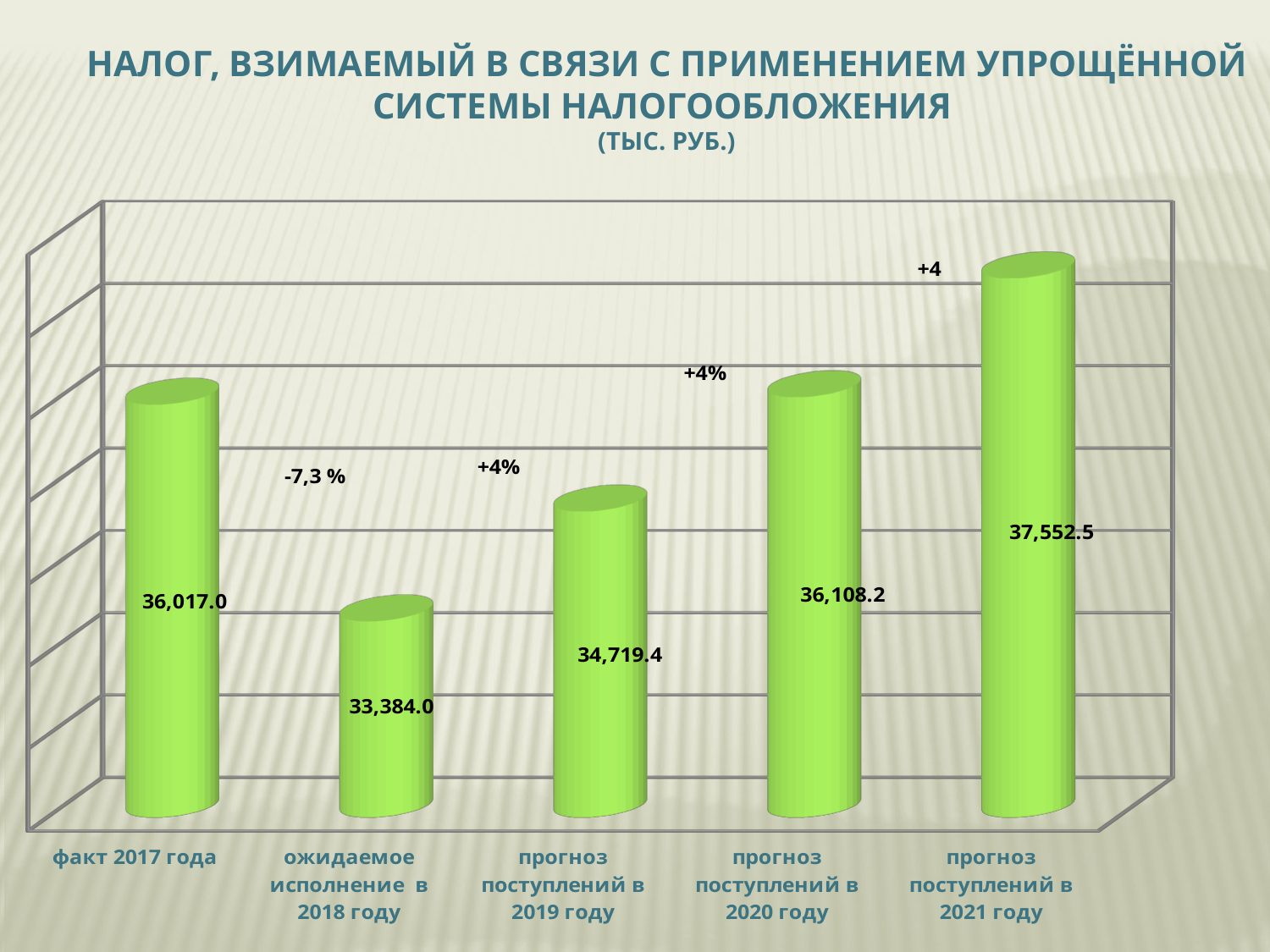
What kind of chart is shown on the slide? bar chart What is the value for прогноз поступлений в 2021 году? 37,552.5 What is the value for прогноз поступлений в 2019 году? 34,719.4 How many categories are shown in the chart? 5 What is the difference between the values for факт 2017 года and ожидаемое исполнение в 2018 году? 2,633.0 What is the difference between the values for прогноз поступлений в 2021 году and прогноз поступлений в 2020 году? 1,444.3 Which is larger, the value for факт 2017 года or the value for прогноз поступлений в 2019 году? факт 2017 года Which category has the highest value? прогноз поступлений в 2021 году What is the value for факт 2017 года? 36,017.0 What unit is given in the chart title? тыс. руб. What is the value for ожидаемое исполнение в 2018 году? 33,384.0 Which category has the lowest value? ожидаемое исполнение в 2018 году